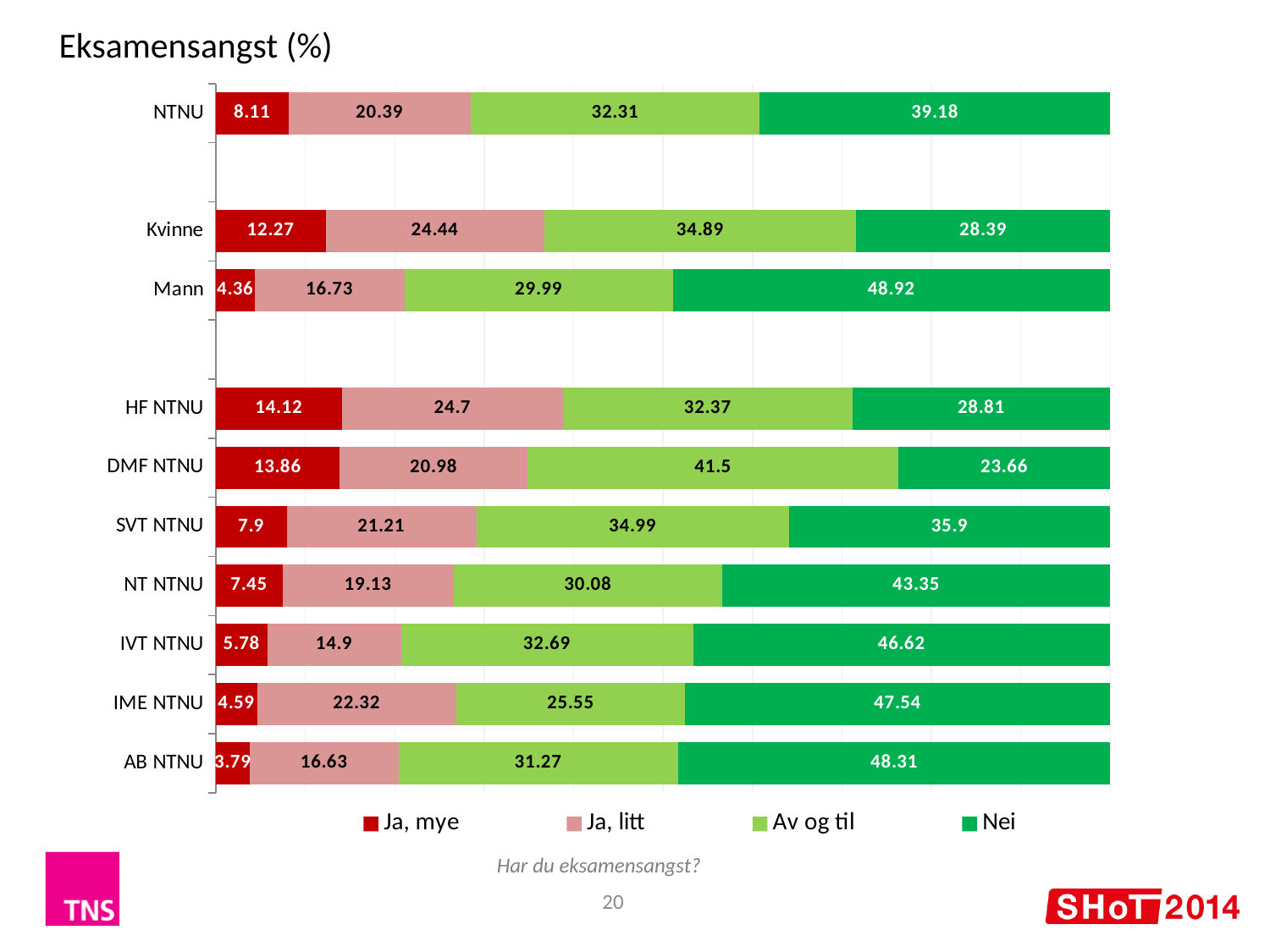
How many categories are shown on the chart? 10 What is the value of "Ja, litt" for IME NTNU? 22.32 Which category has the highest value for "Nei"? Mann What is the value of "Nei" for NTNU? 39.18 What is the value of "Ja, mye" for Kvinne? 12.27 Which category has the highest value for "Ja, mye"? HF NTNU Which category has the lowest value for "Ja, mye"? AB NTNU How many series does the legend list? 4 Which has a larger "Av og til" value, SVT NTNU or NT NTNU? SVT NTNU What is the difference between the "Nei" values for Mann and Kvinne? 20.53 What is the value of "Av og til" for DMF NTNU? 41.5 What kind of chart is shown on the slide? Stacked bar chart